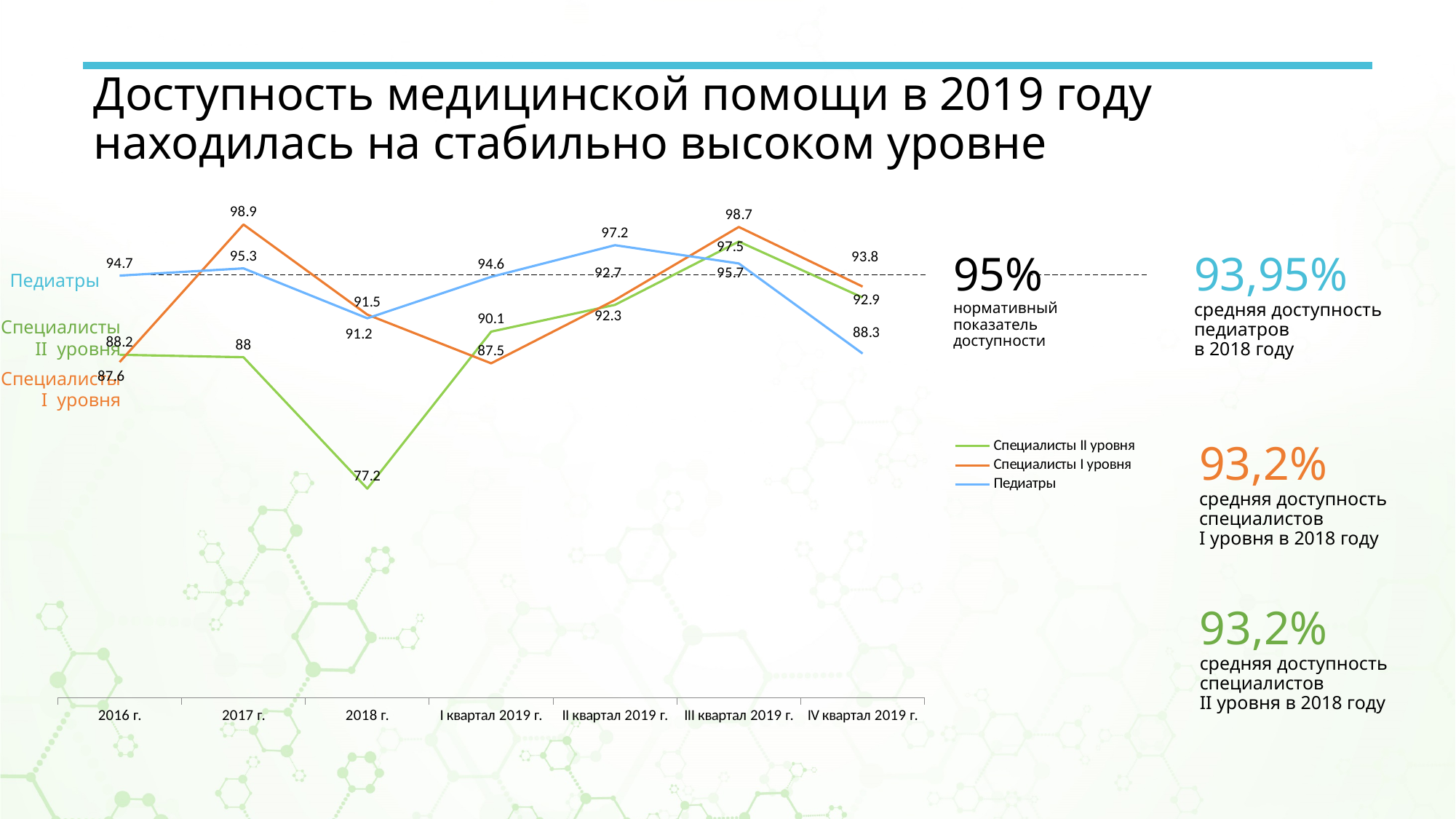
What is the value for Педиатры in 2017 г.? 95.3 What value does the dashed horizontal line (нормативный показатель доступности) mark? 95% What is the value for Специалисты I уровня in 2017 г.? 98.9 What kind of chart is shown on the slide? Line chart In which period does the Педиатры series reach its highest value? II квартал 2019 г. What is the difference between the Специалисты I уровня values in 2017 г. and 2018 г.? 7.4 How many series does the legend list? 3 In which period does the Специалисты II уровня series reach its lowest value? 2018 г. Does the Специалисты II уровня series rise or fall from 2018 г. to III квартал 2019 г.? Rise How many periods are shown on the x axis? 7 What is the value for Специалисты II уровня in IV квартал 2019 г.? 92.9 In III квартал 2019 г., which is larger: Специалисты I уровня or Педиатры? Специалисты I уровня